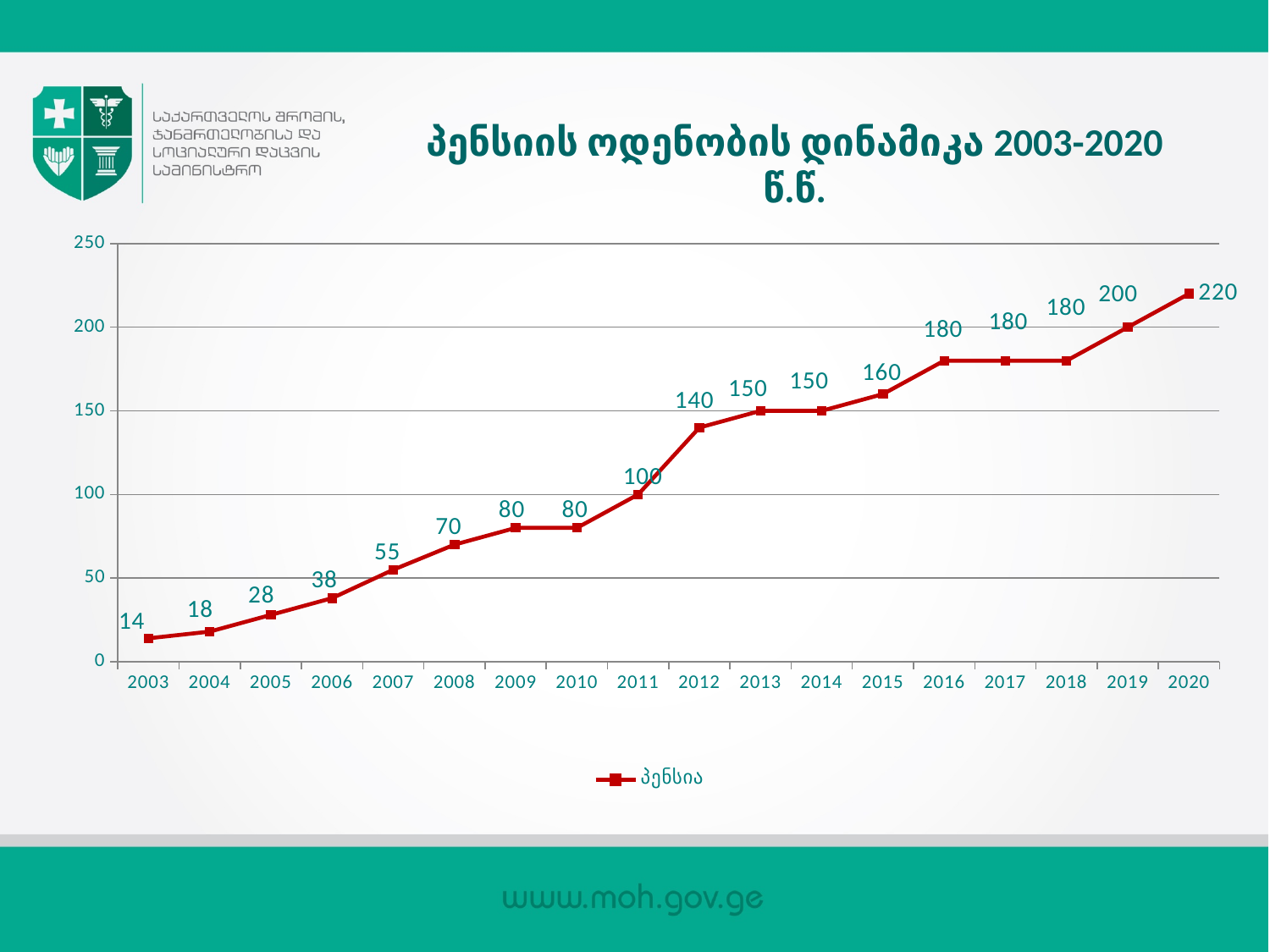
Which year has the lowest pension value? 2003 What is the difference between the pension values for 2012 and 2011? 40 What is the difference between the pension values for 2020 and 2003? 206 Which is larger, the pension value for 2007 or for 2009? 2009 What is the pension value for 2012? 140 How many series does the legend list? 1 Which year has the highest pension value? 2020 Do the pension values generally rise or fall from 2003 to 2020? rise How many years are plotted on the x axis? 18 What is the pension value for 2003? 14 What is the pension value for 2020? 220 What kind of chart is shown on the slide? line chart